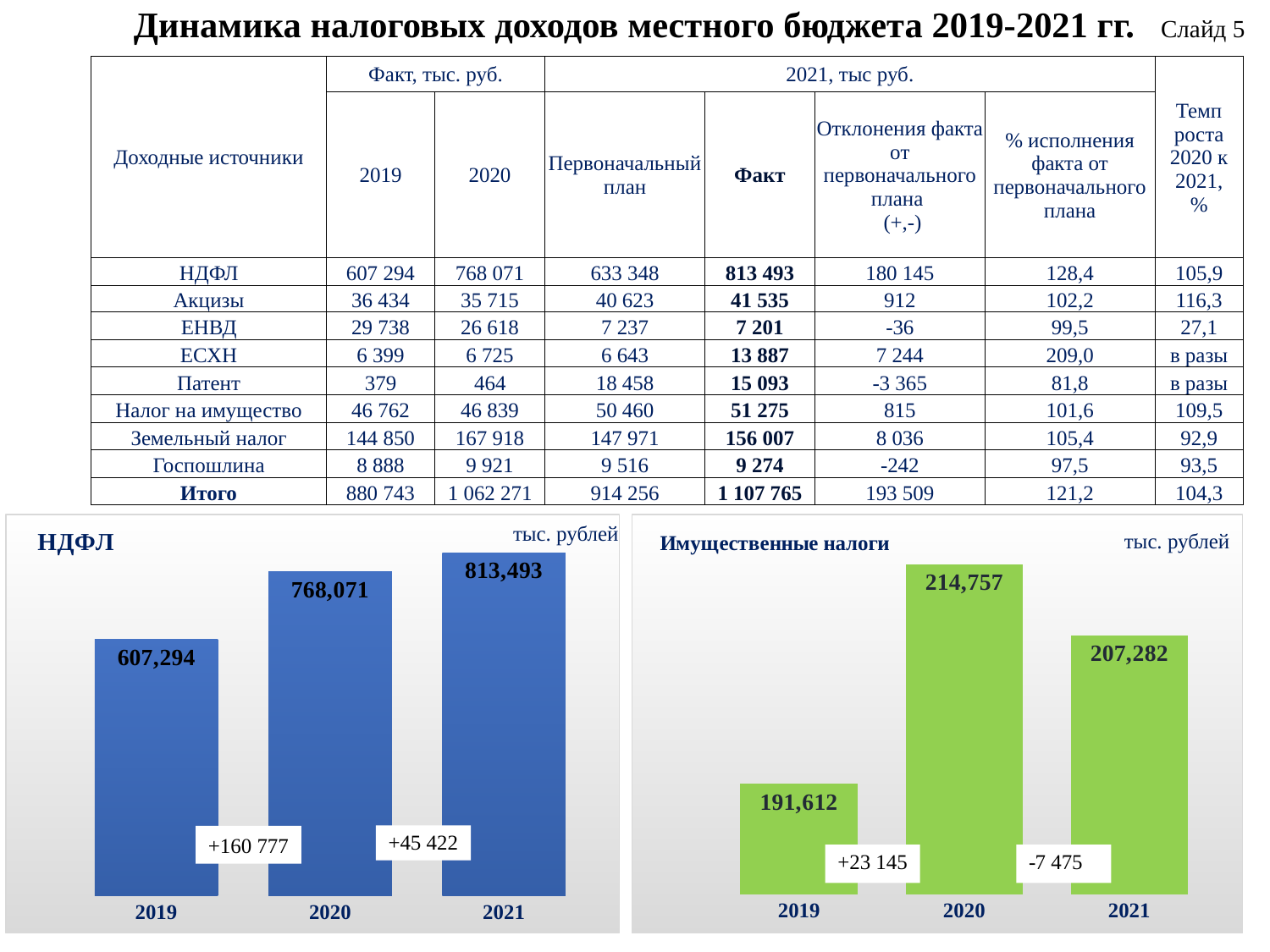
In the Имущественные налоги chart, which is larger, the value for 2020 or the value for 2021? 2020 In the Имущественные налоги chart, which year has the lowest value? 2019 In the Имущественные налоги chart, what is the value for 2020? 214,757 In the Имущественные налоги chart, which year has the highest value? 2020 In the НДФЛ chart, which year has the highest value? 2021 In the Имущественные налоги chart, what is the value for 2019? 191,612 Do the values in the НДФЛ chart rise or fall from 2019 to 2021? rise In the Имущественные налоги chart, what is the difference between the 2020 and 2021 values? 7,475 In the НДФЛ chart, what is the difference between the 2021 and 2020 values? 45,422 In the НДФЛ chart, what is the value for 2019? 607,294 In the НДФЛ chart, what is the value for 2021? 813,493 How many bars are shown in the НДФЛ chart? 3